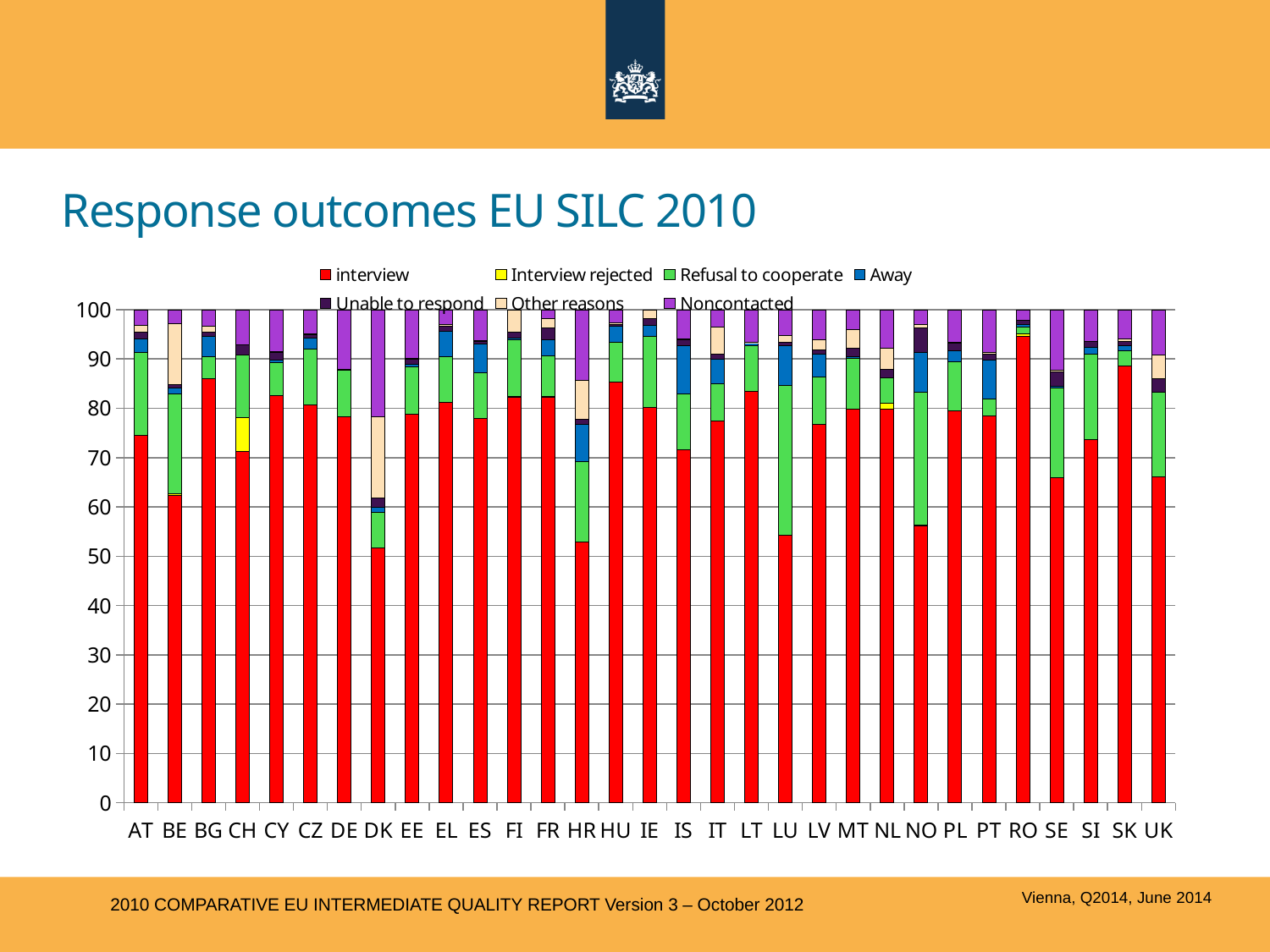
Is the 'interview' value for BE greater or less than 70? less How many countries are shown along the x axis of the chart? 31 Which has the larger 'interview' share, BG or BE? BG Which country has the highest 'interview' share in the chart? RO What is the title of the chart on the slide? Response outcomes EU SILC 2010 What is the total height of the stacked bar for AT? 100 How many series does the legend of the chart list? 7 Is the 'interview' value for AT greater or less than 70? greater What kind of chart is shown on the slide? stacked bar chart Which colour represents the 'interview' series in the chart? red Is the 'interview' value for LU greater or less than 60? less